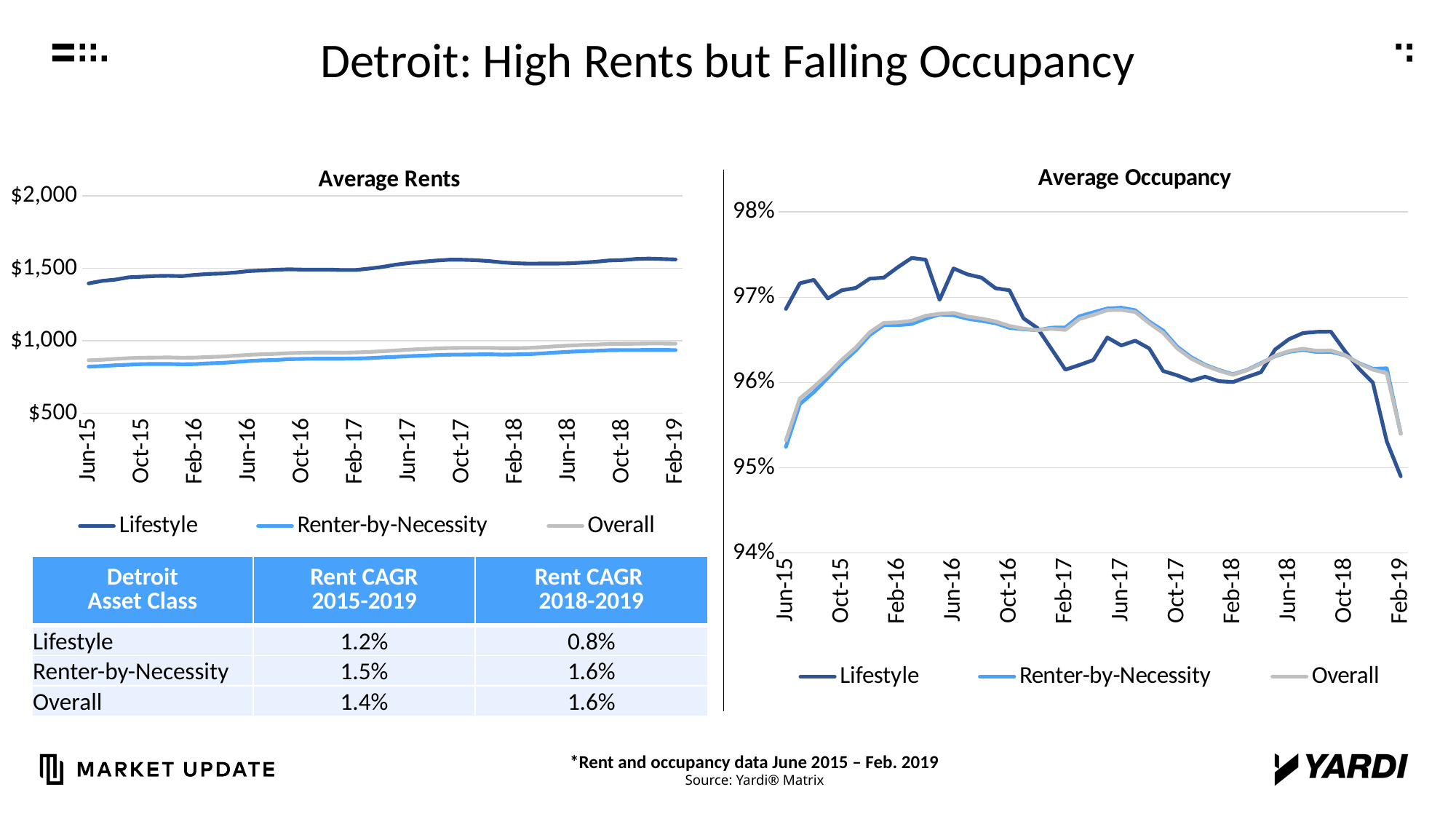
In the Average Rents chart, which series is higher in Feb-19, Lifestyle or Renter-by-Necessity? Lifestyle In the Average Occupancy chart, is the Lifestyle value for Feb-16 greater or less than 97%? greater What kind of chart is the Average Rents chart? line chart In the Average Occupancy chart, is the Overall value for Jun-15 greater or less than 96%? less In the Average Rents chart, does the Lifestyle series generally rise or fall from Jun-15 to Feb-19? rise In the Average Rents chart, is the Renter-by-Necessity value for Jun-15 greater or less than $1,000? less How many series does the legend of the Average Occupancy chart list? 3 In the Average Occupancy chart, does the Lifestyle series rise or fall from Oct-18 to Feb-19? fall In the Average Occupancy chart, which series is higher in Jun-15, Lifestyle or Overall? Lifestyle What is the title of the chart on the right side of the slide? Average Occupancy